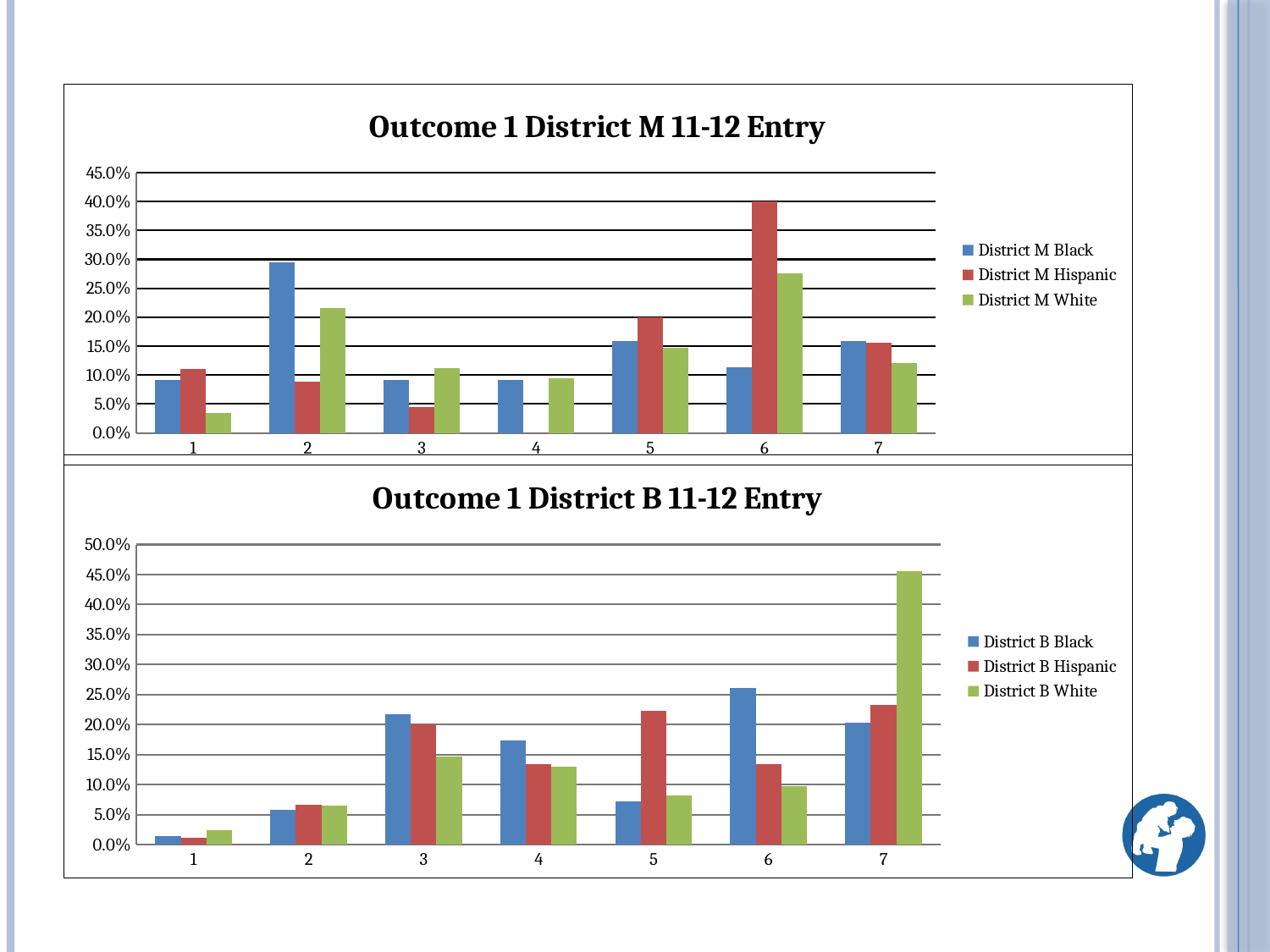
In the 'Outcome 1 District B 11-12 Entry' chart, at which category is the District B White value highest? 7 What kind of chart is the 'Outcome 1 District M 11-12 Entry' chart? Bar chart In the 'Outcome 1 District B 11-12 Entry' chart, for category 5, which is larger: District B Black or District B Hispanic? District B Hispanic In the 'Outcome 1 District M 11-12 Entry' chart, is the District M White value for category 1 greater or less than 5.0%? less In the 'Outcome 1 District M 11-12 Entry' chart, how many series does the legend list? 3 In the 'Outcome 1 District M 11-12 Entry' chart, is the District M Hispanic value for category 6 greater or less than 35.0%? greater In the 'Outcome 1 District M 11-12 Entry' chart, at which category is the District M Hispanic value highest? 6 In the 'Outcome 1 District M 11-12 Entry' chart, for category 2, which is larger: District M Black or District M White? District M Black In the 'Outcome 1 District B 11-12 Entry' chart, is the District B White value for category 7 greater or less than 40.0%? greater In the 'Outcome 1 District M 11-12 Entry' chart, how many categories are shown on the x axis? 7 What are the legend entries of the 'Outcome 1 District B 11-12 Entry' chart? District B Black, District B Hispanic, District B White In the 'Outcome 1 District B 11-12 Entry' chart, at which category is the District B Black value lowest? 1